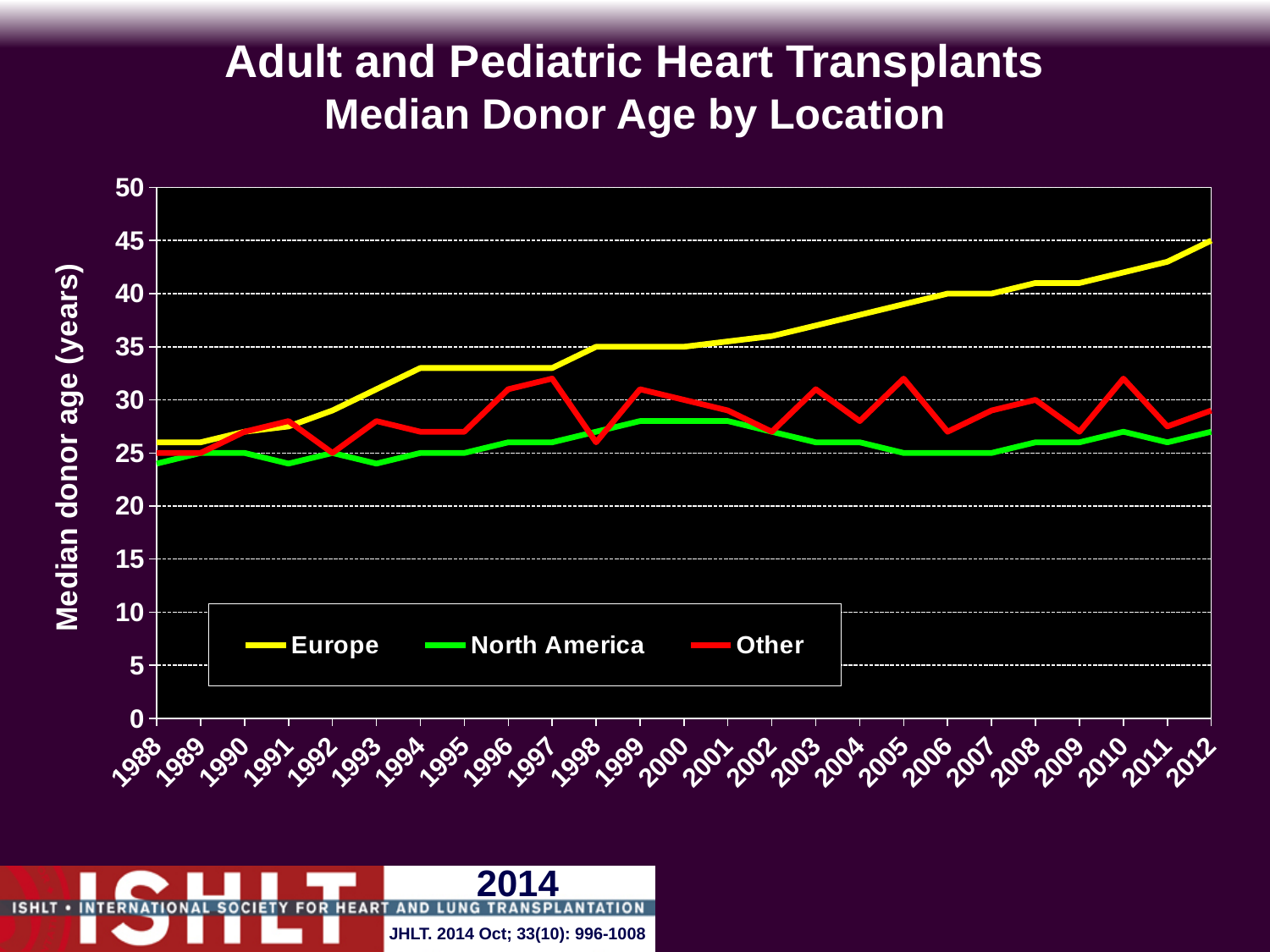
How many series does the legend list? 3 Is the median donor age for Other in 2005 greater or less than 30? greater In 2012, which is larger: the median donor age for Europe or for North America? Europe Which series has the highest median donor age in 2012? Europe What colour is the line for Europe in the legend? yellow Does the median donor age for Europe rise or fall from 1988 to 2012? rise Is the median donor age for Europe in 2012 greater or less than 40? greater Which series has the lowest median donor age in 2005? North America Is the median donor age for Europe in 1988 greater or less than 30? less How many years are shown along the x axis? 25 What kind of chart is shown on the slide? line chart